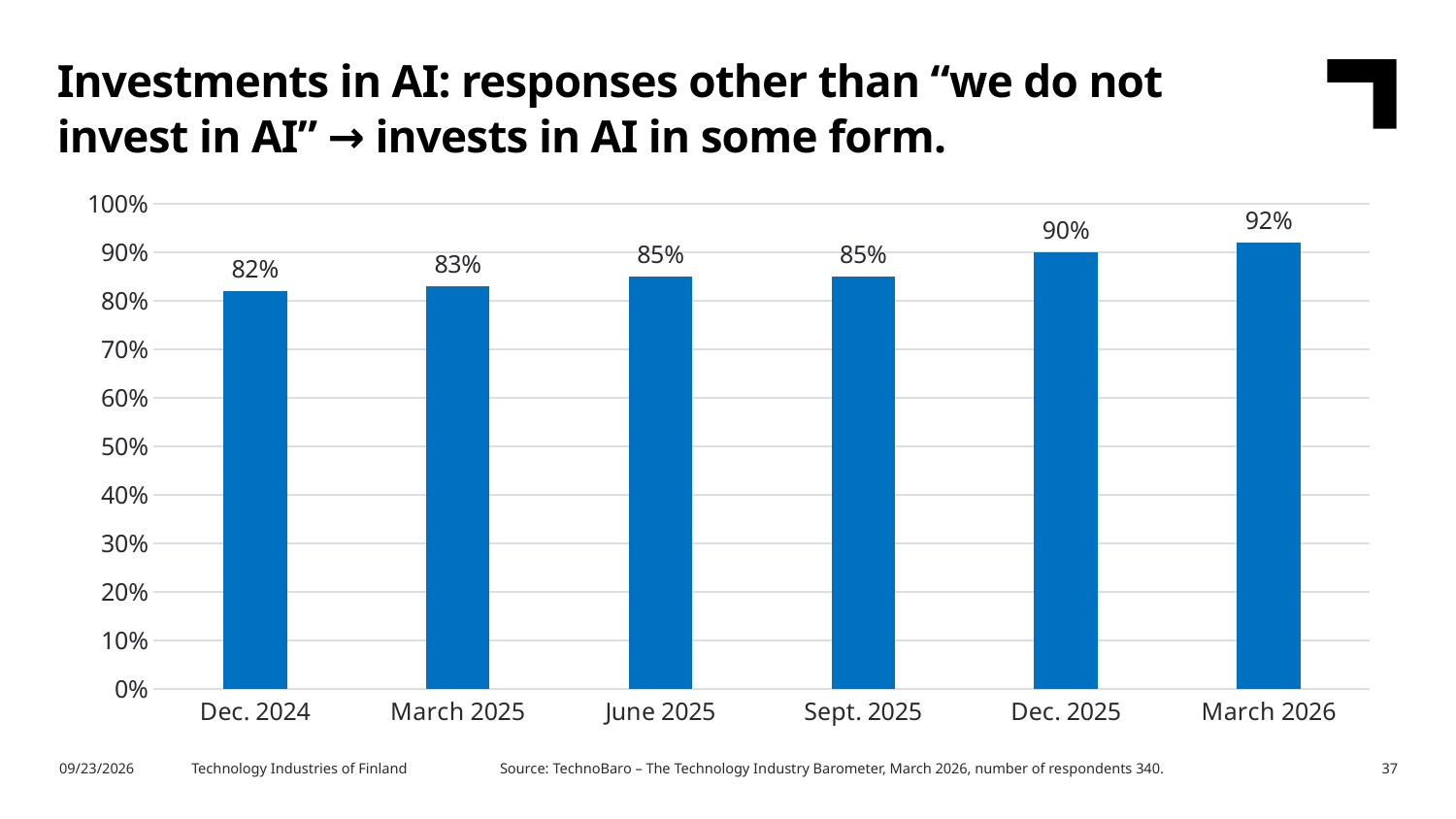
What is the value for Dec. 2024? 82% Do the values rise or fall from Dec. 2024 to March 2026? rise What is the value for Dec. 2025? 90% Is the value for Sept. 2025 greater or less than 80%? greater What is the difference between the values for March 2026 and Dec. 2024? 10% What is the difference between the values for Dec. 2025 and Sept. 2025? 5% Which period has the lowest value? Dec. 2024 How many periods are shown on the x axis? 6 Which period has the highest value? March 2026 What is the value for June 2025? 85% Which is larger, the value for March 2025 or the value for Dec. 2025? Dec. 2025 What kind of chart is shown on the slide? bar chart